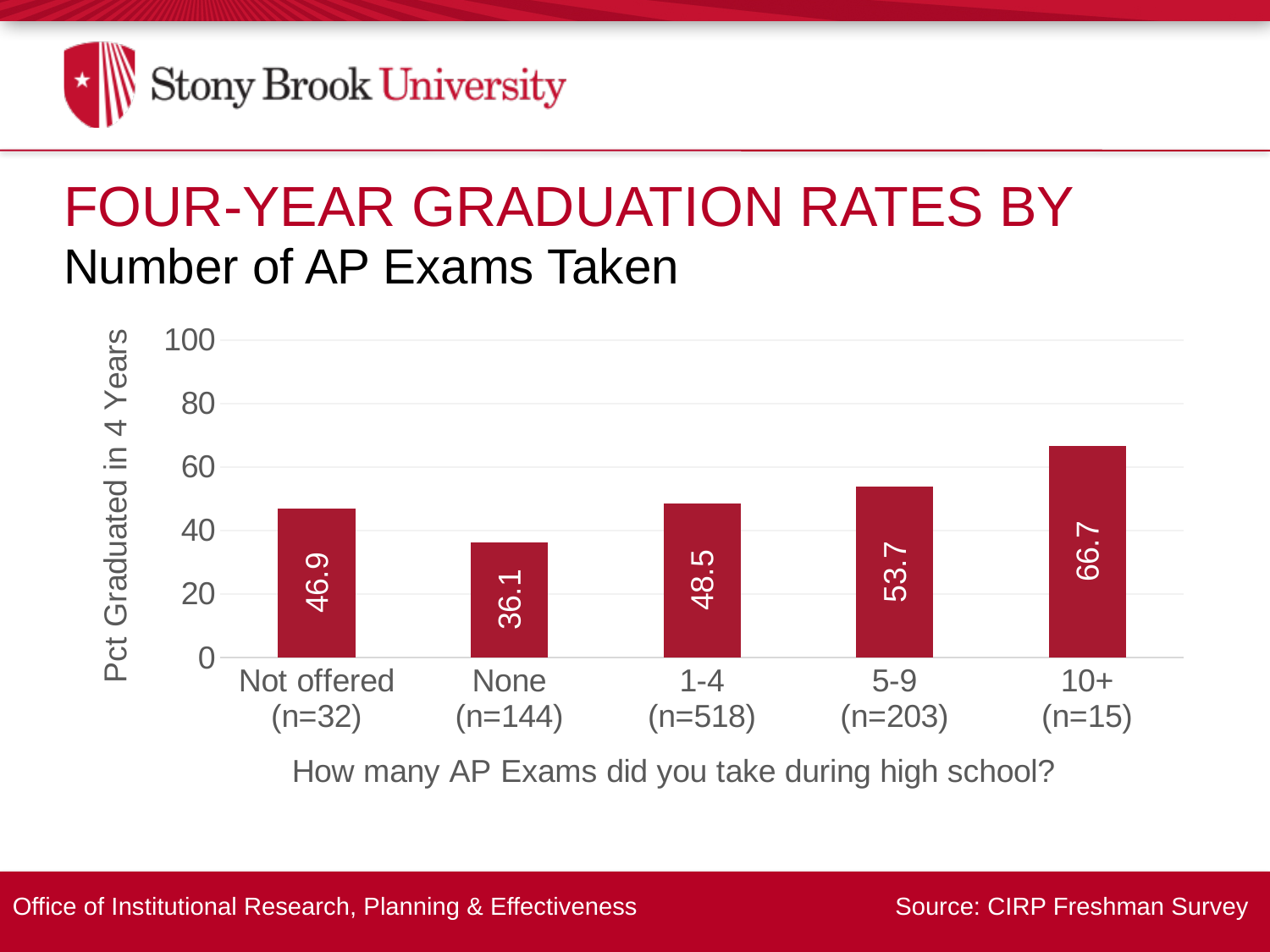
What is the difference between the graduation rates for 5-9 and 1-4? 5.2 Which category has the highest four-year graduation rate? 10+ Which category has the lowest four-year graduation rate? None What is the four-year graduation rate for students who took no AP exams (None)? 36.1 What kind of chart is shown on the slide? bar chart What is the four-year graduation rate for students who took 10+ AP exams? 66.7 What is the label of the y axis? Pct Graduated in 4 Years What is the value for the 'Not offered' category? 46.9 What is the difference between the graduation rates for 10+ and None? 30.6 How many categories are shown on the x axis? 5 Is the value for 5-9 greater or less than 60? less Which has a higher graduation rate, 'Not offered' or '1-4'? 1-4